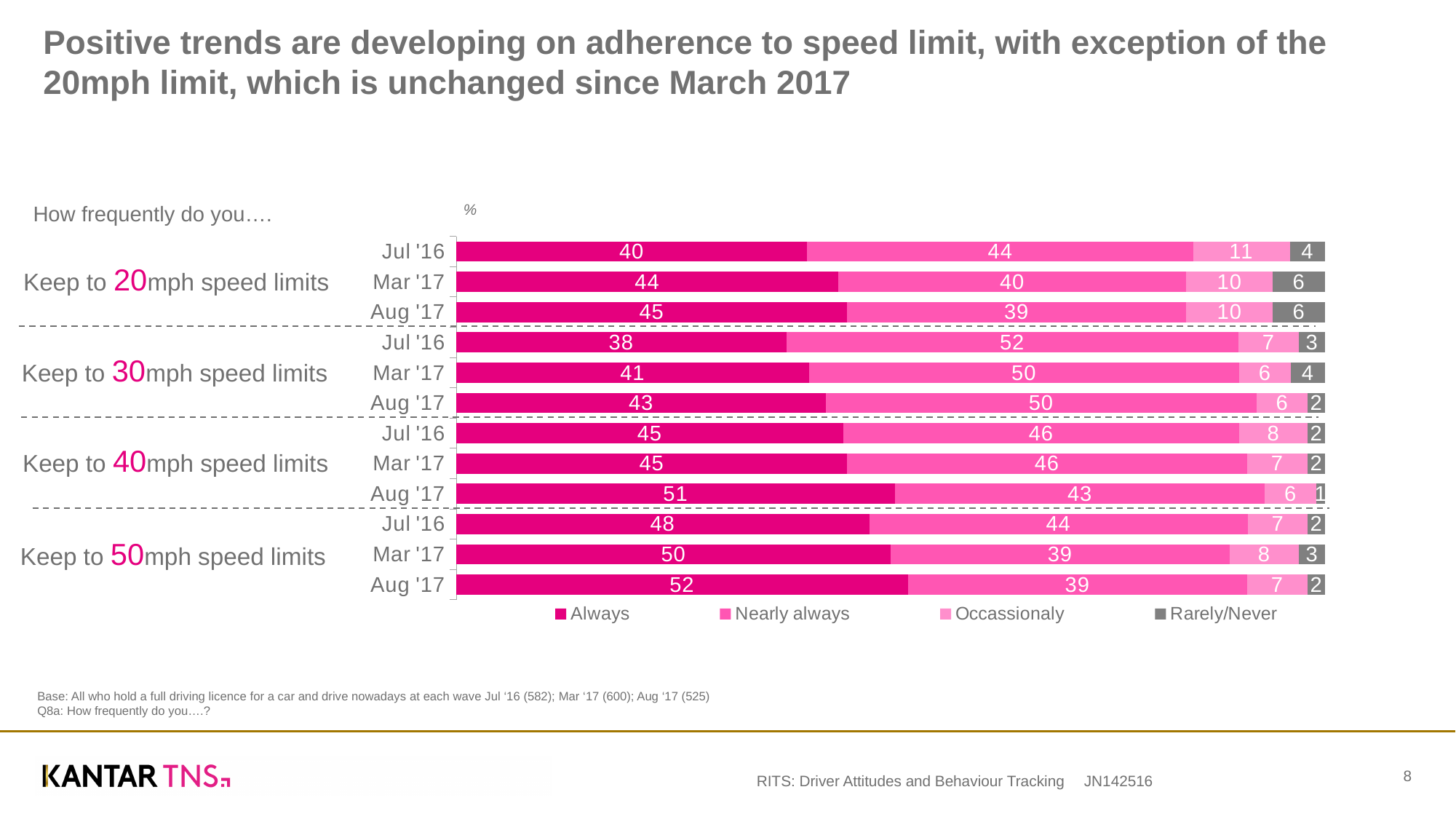
For Keep to 40mph speed limits, which wave has the highest 'Always' value? Aug '17 What is the 'Always' value for Keep to 50mph speed limits in Aug '17? 52 Which is larger: the 'Always' value for Keep to 50mph speed limits in Mar '17 or for Keep to 30mph speed limits in Mar '17? Keep to 50mph speed limits in Mar '17 What is the 'Rarely/Never' value for Keep to 20mph speed limits in Mar '17? 6 Does the 'Always' value for Keep to 50mph speed limits rise or fall from Jul '16 to Aug '17? Rise What is the total of the four segments in the Keep to 20mph speed limits Jul '16 bar? 99 For Keep to 30mph speed limits, which wave has the lowest 'Always' value? Jul '16 How many series does the legend list? 4 What is the 'Nearly always' value for Keep to 30mph speed limits in Jul '16? 52 What kind of chart is shown on the slide? Stacked bar chart How many bars are plotted in the chart? 12 What is the difference between the 'Always' values for Keep to 20mph speed limits in Aug '17 and Jul '16? 5